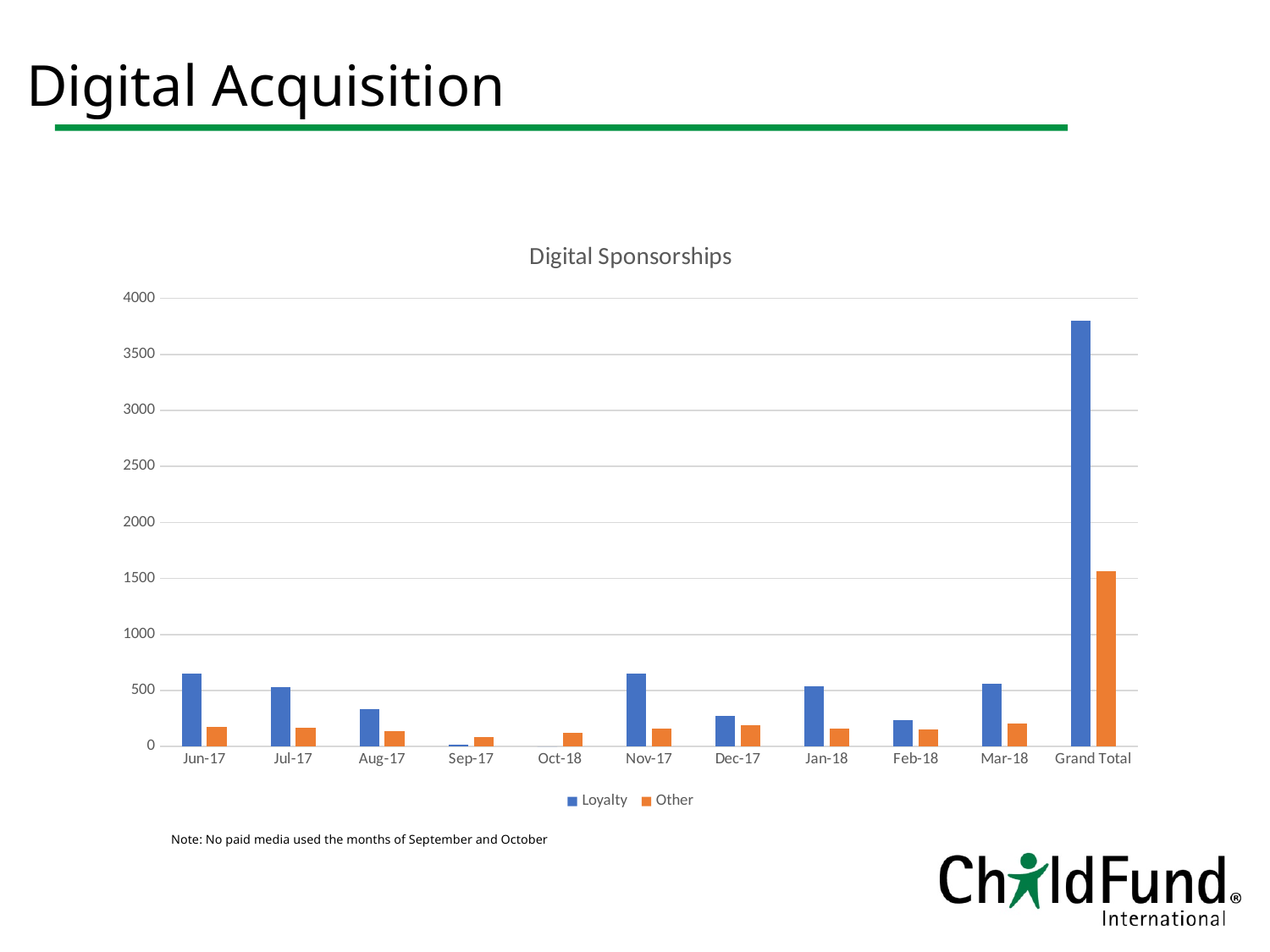
Which category has the lowest Loyalty value? Oct-18 Is the Loyalty value for Jun-17 greater or less than 500? greater For Jun-17, which is larger: Loyalty or Other? Loyalty How many categories are shown on the x axis? 11 What is the title of the chart? Digital Sponsorships Is the Loyalty value for Grand Total greater or less than 3500? greater For Oct-18, which is larger: Loyalty or Other? Other How many series does the legend list? 2 Which category has the highest Loyalty value? Grand Total Is the Loyalty value for Aug-17 greater or less than 500? less What type of chart is shown on the slide? bar chart